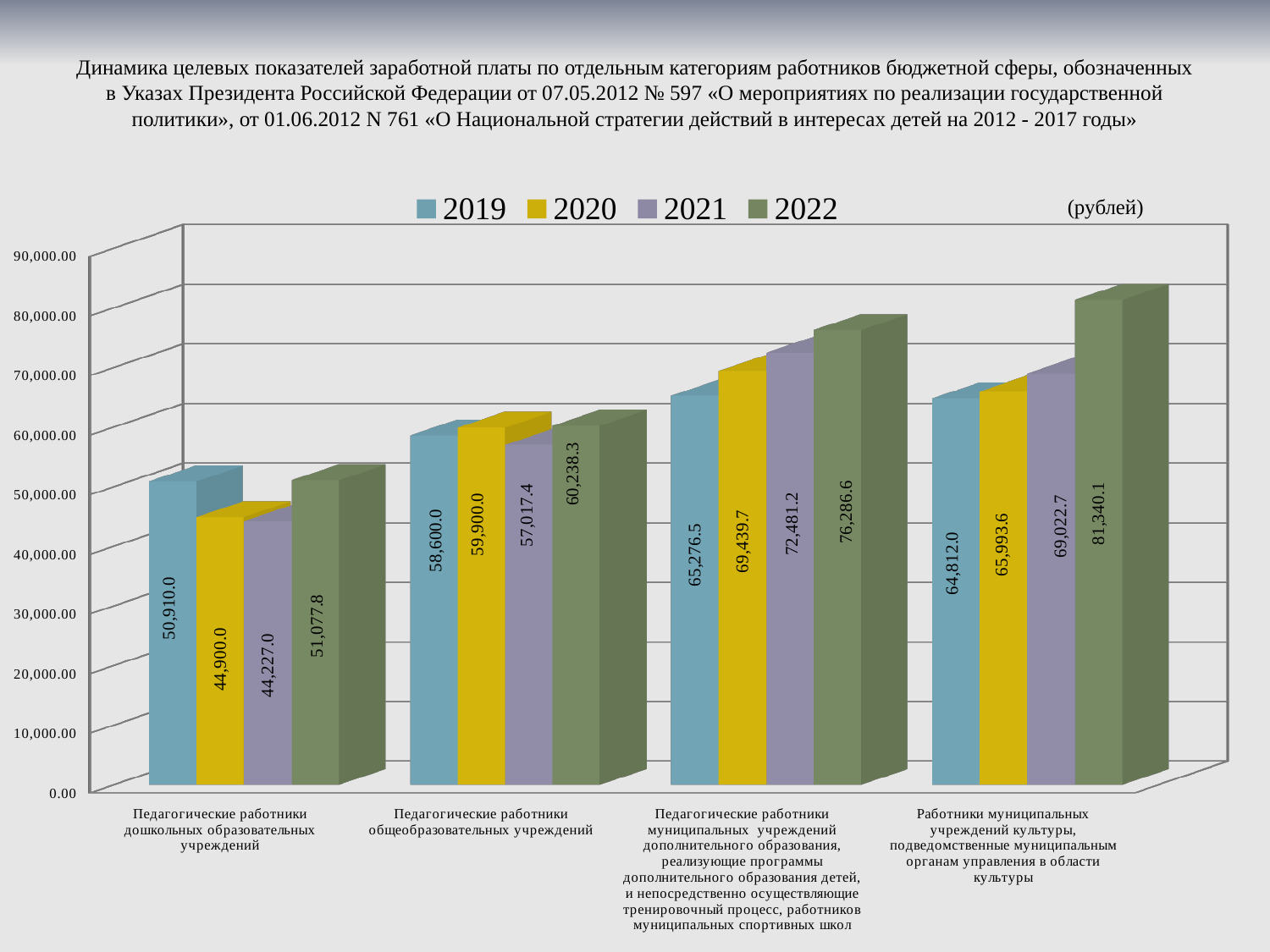
What is the 2021 value for Педагогические работники общеобразовательных учреждений? 57,017.4 Which year has the lowest value for Педагогические работники дошкольных образовательных учреждений? 2021 What unit is indicated next to the legend? рублей How many categories of workers are shown on the x axis? 4 What is the difference between the 2022 and 2021 values for Работники муниципальных учреждений культуры? 12,317.4 What type of chart is shown on the slide? Bar chart How many series does the legend list? 4 Which category has the highest 2022 value? Работники муниципальных учреждений культуры What is the 2020 value for Педагогические работники дошкольных образовательных учреждений? 44,900.0 Which is larger for Педагогические работники общеобразовательных учреждений: the 2019 value or the 2020 value? 2020 What is the 2022 value for Работники муниципальных учреждений культуры? 81,340.1 Do the values for Педагогические работники муниципальных учреждений дополнительного образования rise or fall from 2019 to 2022? Rise